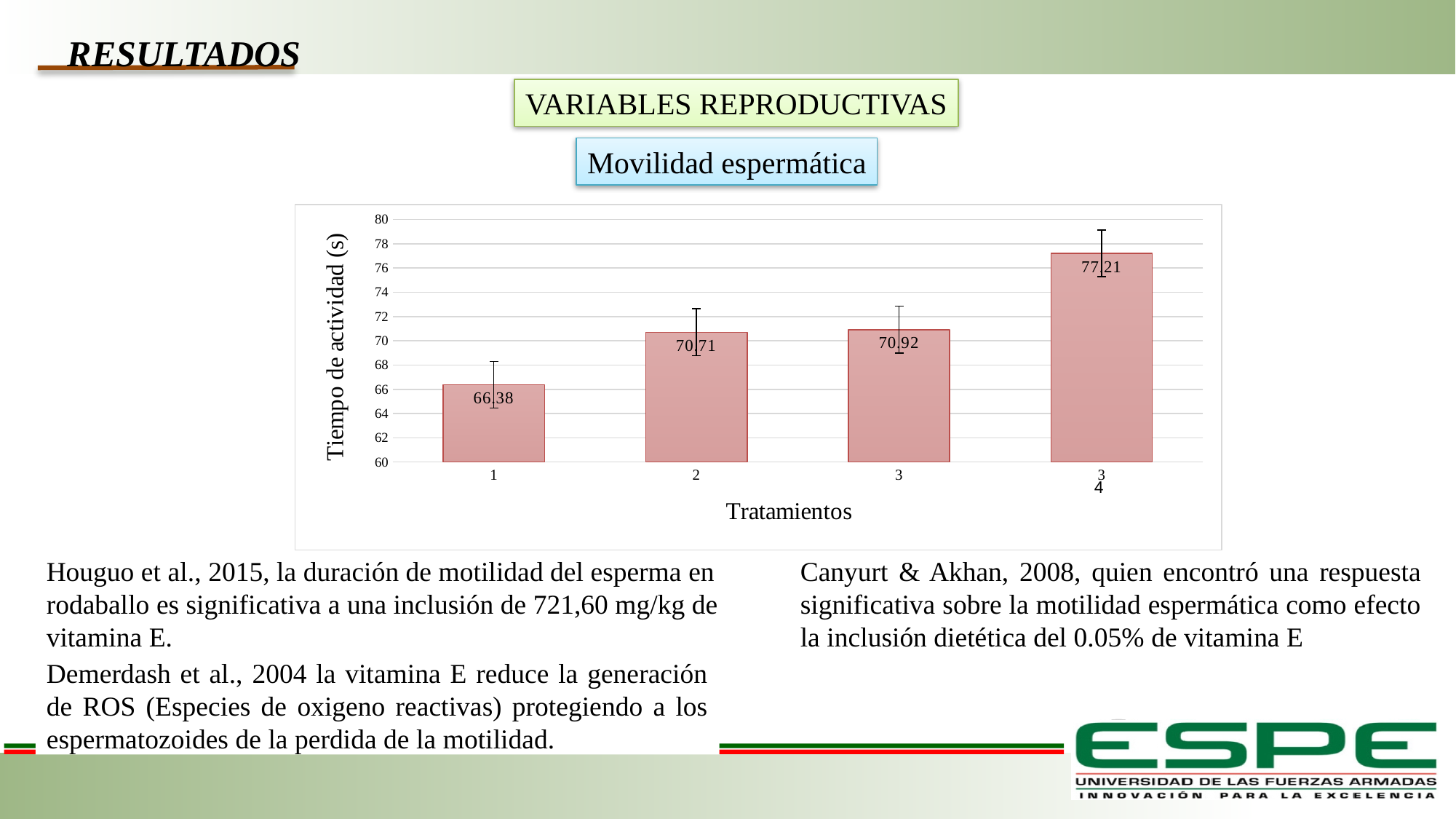
What is the value for treatment 2 in the Movilidad espermática chart? 70.71 How many bars are plotted in the Movilidad espermática chart? 4 What is the difference between the rightmost bar (77.21) and treatment 1 (66.38) in the Movilidad espermática chart? 10.83 Is the value for treatment 1 in the Movilidad espermática chart greater or less than 68? less What is the value shown on the rightmost (fourth) bar in the Movilidad espermática chart? 77.21 What is the value for treatment 1 in the Movilidad espermática chart? 66.38 What is the value for treatment 3 in the Movilidad espermática chart? 70.92 What is the difference between treatment 2 and treatment 1 in the Movilidad espermática chart? 4.33 Which treatment has the lowest value in the Movilidad espermática chart? Treatment 1 What kind of chart is shown on the slide? Bar chart Which is larger in the Movilidad espermática chart, the value for treatment 1 or the value for treatment 2? Treatment 2 Which bar has the highest value in the Movilidad espermática chart? The rightmost (fourth) bar, 77.21